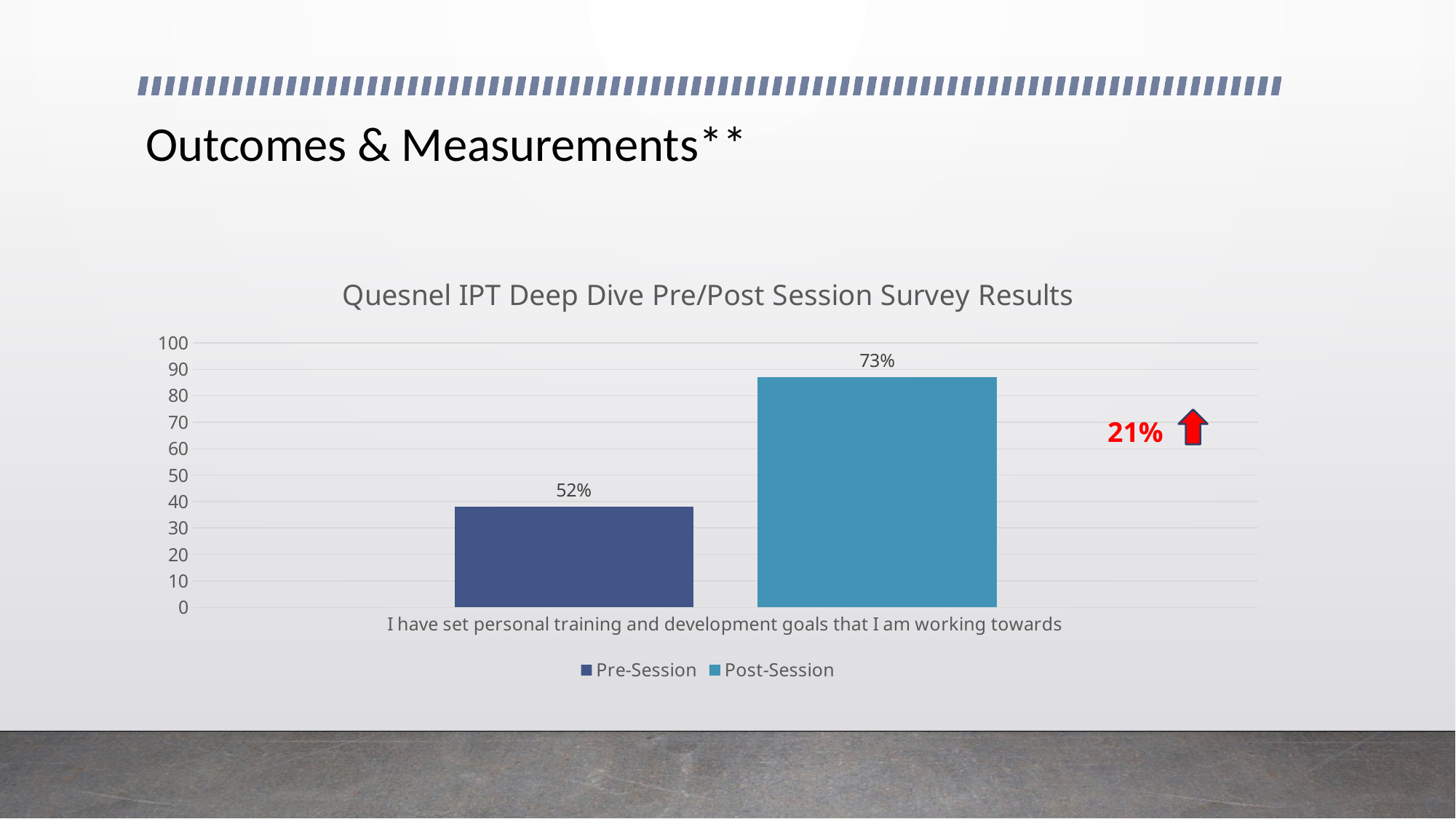
Which series has the highest value in the chart? Post-Session What is the title of the chart? Quesnel IPT Deep Dive Pre/Post Session Survey Results What is the Pre-Session value for "I have set personal training and development goals that I am working towards"? 52% How many series does the legend list? 2 Which series has the lowest value in the chart? Pre-Session What percentage change is shown next to the red arrow on the slide? 21% What are the two series named in the legend? Pre-Session and Post-Session What kind of chart is shown on the slide? Bar chart Which series has the higher value, Pre-Session or Post-Session? Post-Session What is the Post-Session value for "I have set personal training and development goals that I am working towards"? 73% How many categories are shown on the x axis? 1 What is the difference between the Post-Session and Pre-Session values? 21%